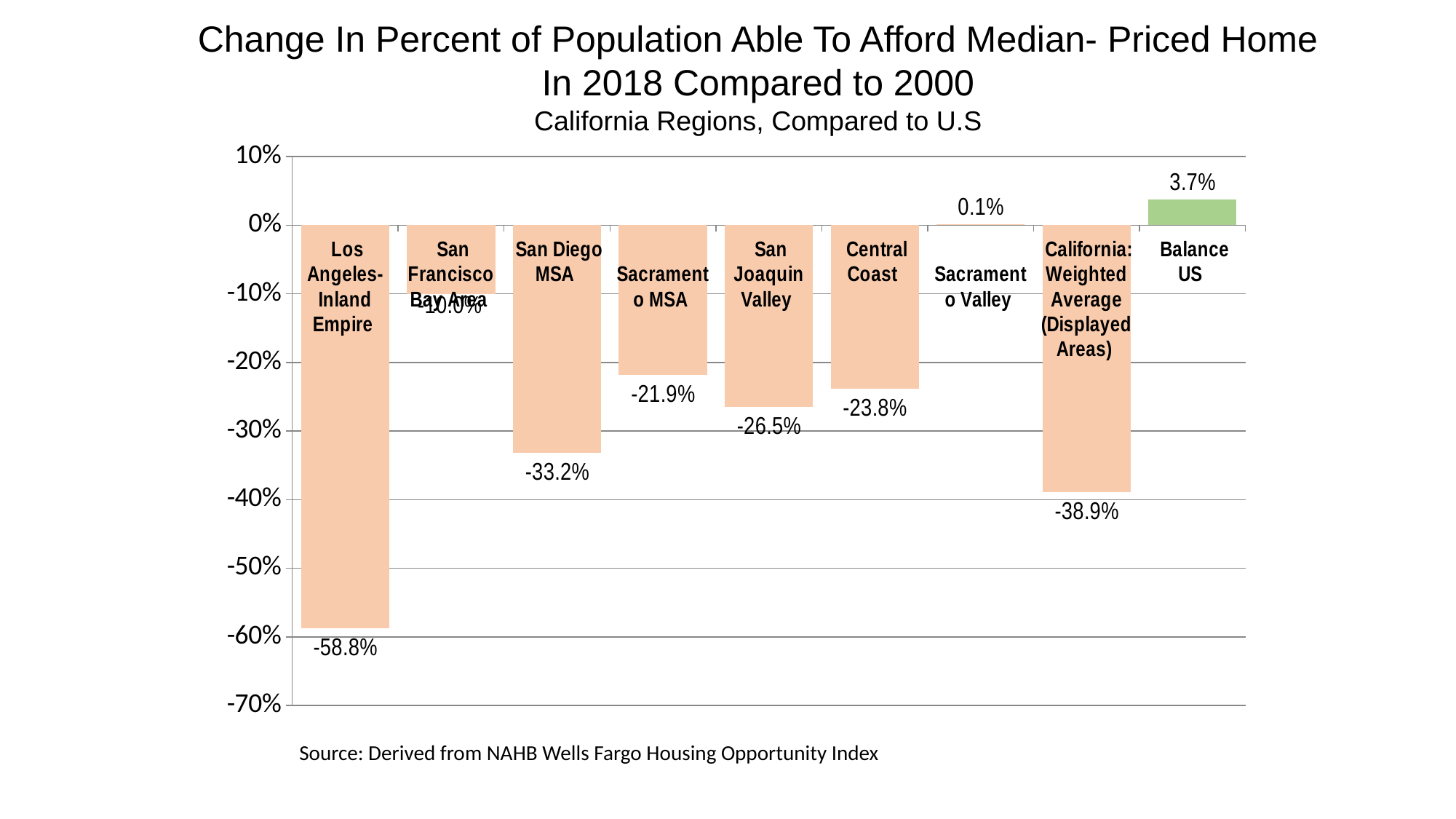
Which is larger, the value for San Joaquin Valley or the value for Central Coast? Central Coast What is the value for California: Weighted Average (Displayed Areas)? -38.9% What is the value for San Diego MSA? -33.2% What is the value for Balance US? 3.7% What kind of chart is this? Bar chart Which category has the lowest value? Los Angeles-Inland Empire Which category has the highest value? Balance US How many categories are shown on the chart? 9 What is the value for Los Angeles-Inland Empire? -58.8% What is the source cited below the chart? Derived from NAHB Wells Fargo Housing Opportunity Index What is the difference between the values for Central Coast and Sacramento MSA? 1.9 percentage points What is the value for Sacramento Valley? 0.1%